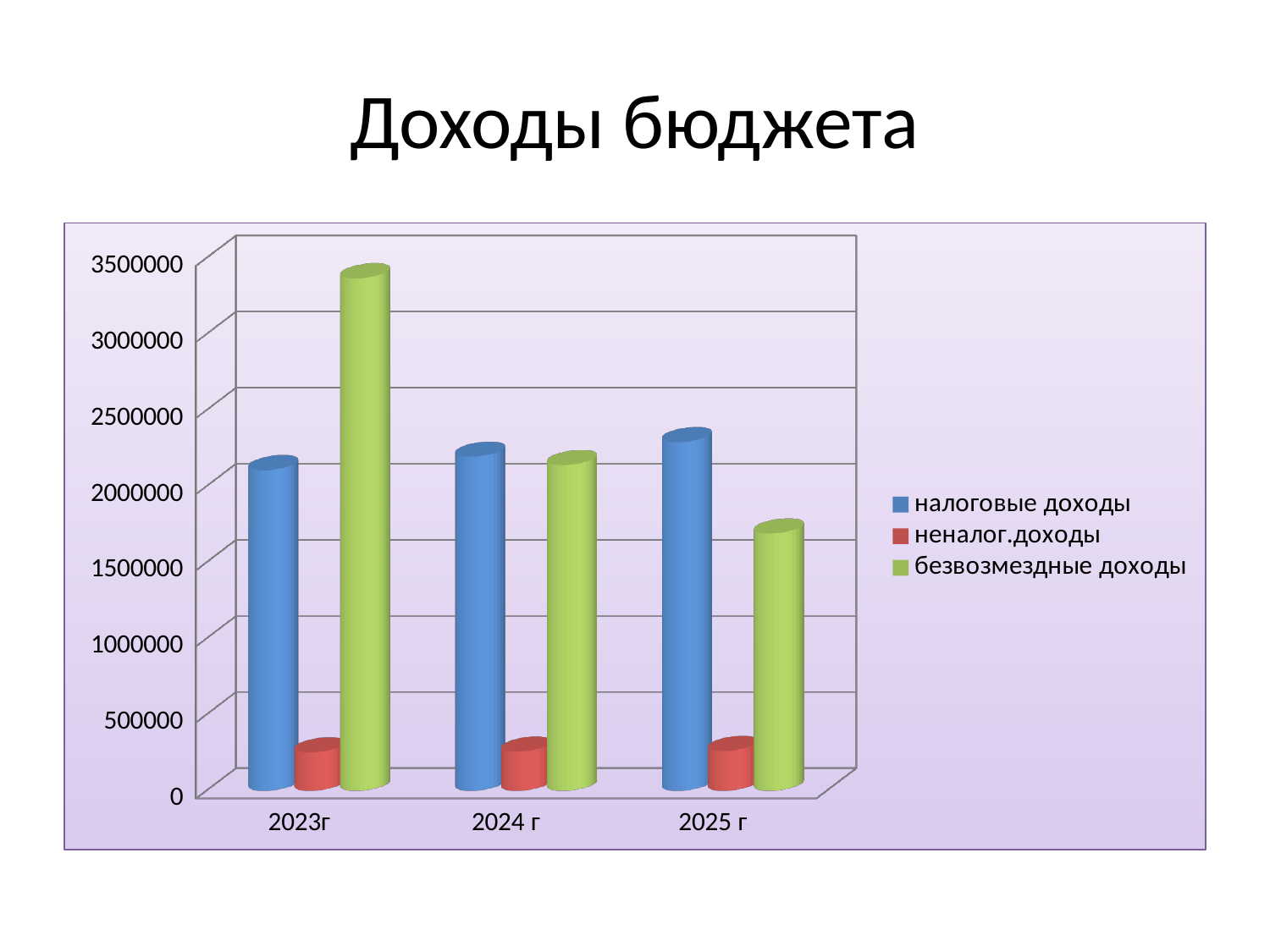
Is the value for безвозмездные доходы in 2025 г greater or less than 2000000? less Is the value for безвозмездные доходы in 2023г greater or less than 3000000? greater Do the values for безвозмездные доходы rise or fall from 2023г to 2025 г? fall What is the title of the chart? Доходы бюджета Which series has the lowest bar in 2025 г? неналог.доходы In 2025 г, which is larger: налоговые доходы or безвозмездные доходы? налоговые доходы How many series does the legend list? 3 Is the value for неналог.доходы in 2024 г greater or less than 500000? less What kind of chart is shown on the slide? bar chart How many categories are shown on the x axis? 3 Which series has the tallest bar in 2023г? безвозмездные доходы